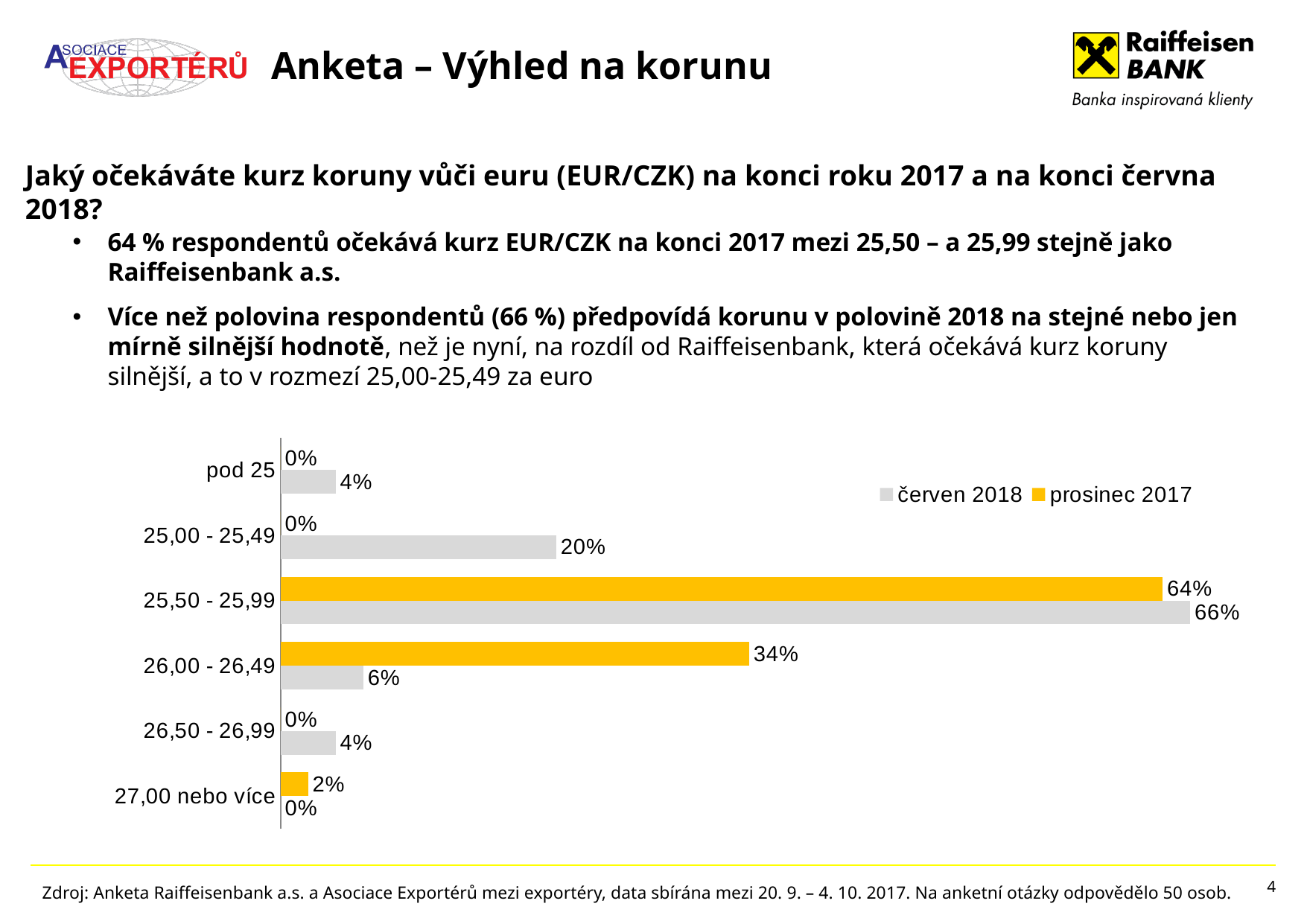
What is the value for červen 2018 in the 26,00 - 26,49 category? 6% Which is larger in the 27,00 nebo více category: prosinec 2017 or červen 2018? prosinec 2017 How many series does the legend list? 2 What is the difference between the červen 2018 and prosinec 2017 values in the 25,50 - 25,99 category? 2% How many categories are shown on the chart? 6 What is the value for červen 2018 in the 25,00 - 25,49 category? 20% Which category has the highest value for červen 2018? 25,50 - 25,99 Which category has the highest value for prosinec 2017? 25,50 - 25,99 What kind of chart is shown on the slide? bar chart What is the difference between the prosinec 2017 and červen 2018 values in the 26,00 - 26,49 category? 28% What is the value for prosinec 2017 in the 25,50 - 25,99 category? 64% What is the value for prosinec 2017 in the 26,00 - 26,49 category? 34%